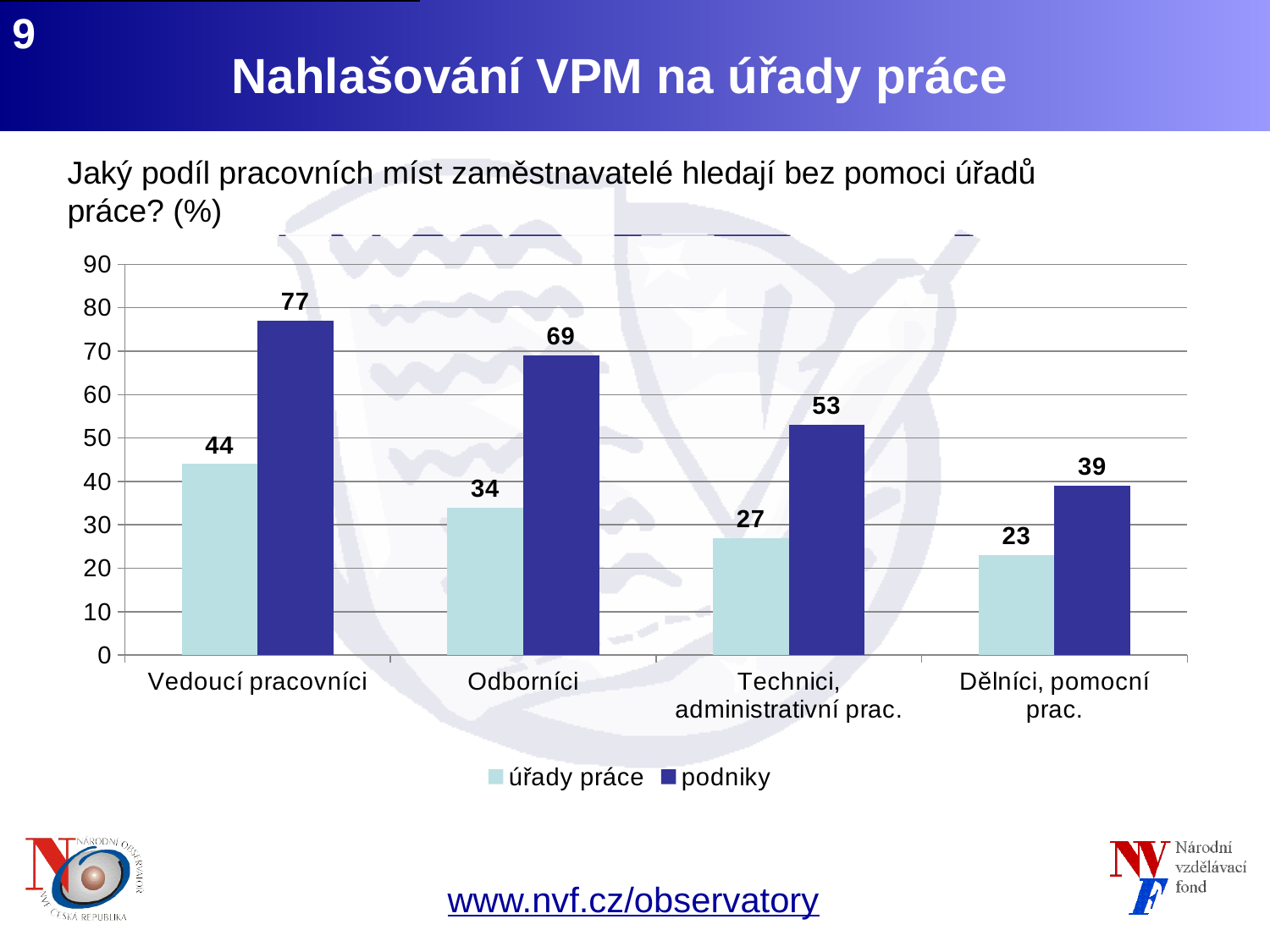
How many categories are shown on the x axis? 4 What is the value for 'úřady práce' in the 'Dělníci, pomocní prac.' category? 23 Which is larger: the 'podniky' value for 'Dělníci, pomocní prac.' or the 'úřady práce' value for 'Vedoucí pracovníci'? úřady práce value for Vedoucí pracovníci What is the value for 'podniky' in the 'Vedoucí pracovníci' category? 77 Which category has the lowest value for the 'úřady práce' series? Dělníci, pomocní prac. What is the value for 'úřady práce' in the 'Technici, administrativní prac.' category? 27 What is the difference between the 'podniky' and 'úřady práce' values for 'Odborníci'? 35 Is the 'podniky' value for 'Technici, administrativní prac.' greater or less than 50? greater How many series does the legend list? 2 What kind of chart is shown on the slide? bar chart Do the 'úřady práce' values rise or fall from left to right across the categories? fall Which category has the highest value for the 'podniky' series? Vedoucí pracovníci